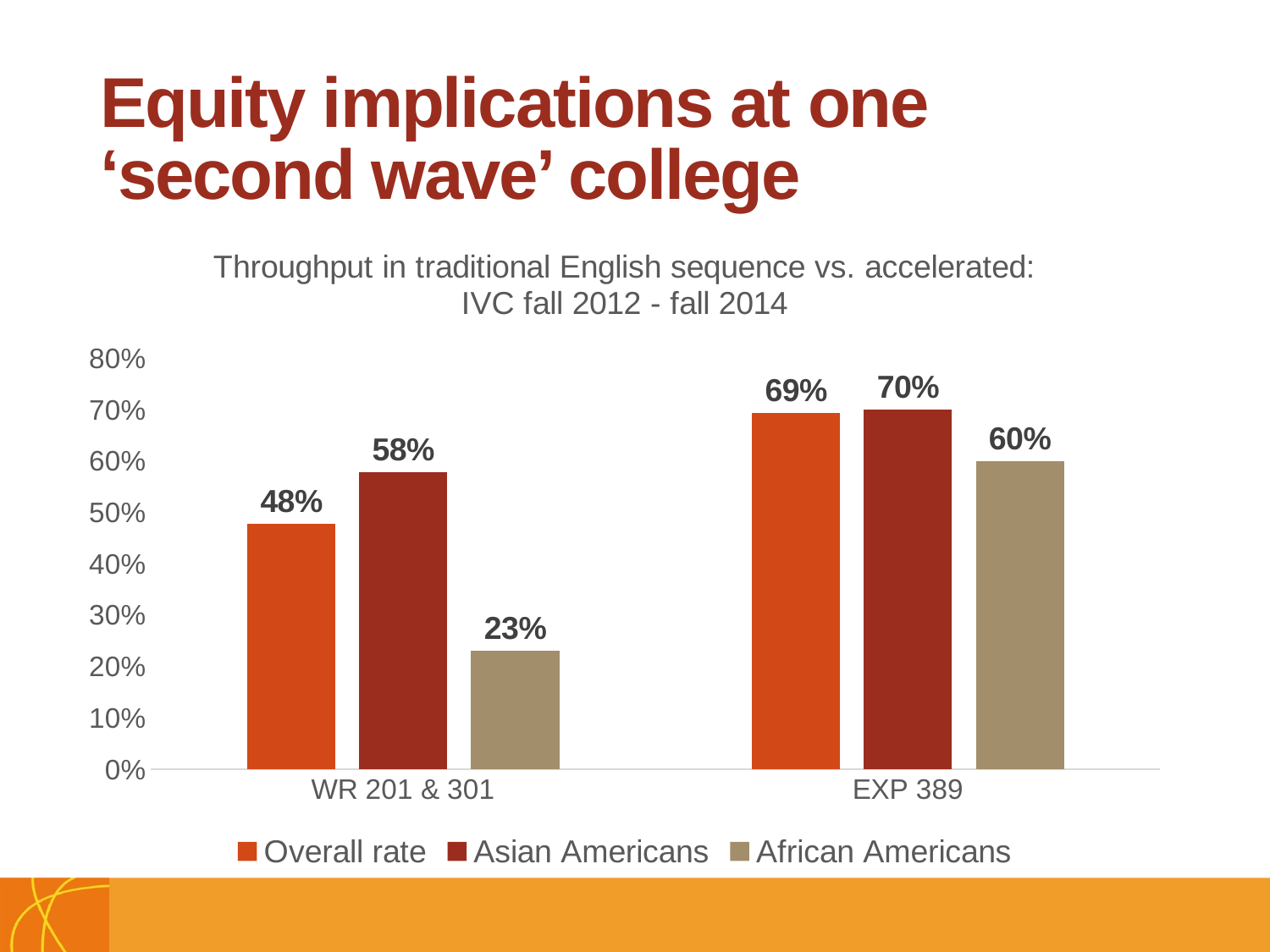
Which is larger: the Overall rate for WR 201 & 301 or the Overall rate for EXP 389? EXP 389 Which series has the lowest value for WR 201 & 301? African Americans What is the value for African Americans in EXP 389? 60% How many categories are shown on the x axis? 2 Which series has the highest value for EXP 389? Asian Americans What is the difference between the Asian Americans and African Americans values for WR 201 & 301? 35% What is the Overall rate for WR 201 & 301? 48% What kind of chart is shown on the slide? Bar chart What is the value for Asian Americans in WR 201 & 301? 58% How many series does the legend list? 3 What is the difference between the African Americans value for EXP 389 and for WR 201 & 301? 37% What is the title of the chart? Throughput in traditional English sequence vs. accelerated: IVC fall 2012 - fall 2014